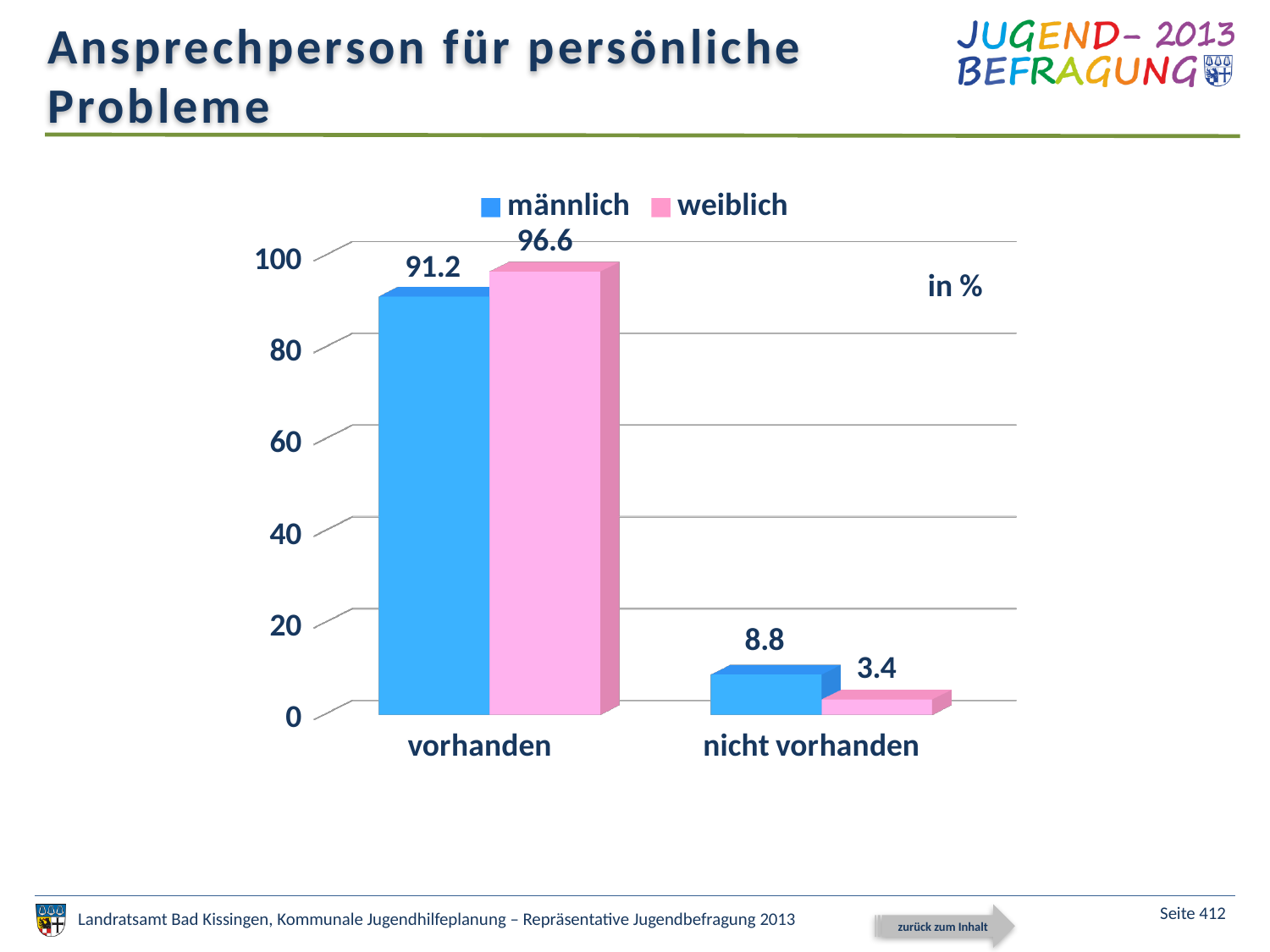
Which series has the higher value in the nicht vorhanden category? männlich What is the difference between the männlich and weiblich values in the nicht vorhanden category? 5.4 How many categories are shown on the x axis? 2 What is the value for weiblich in the nicht vorhanden category? 3.4 What is the value for männlich in the vorhanden category? 91.2 What is the value for männlich in the nicht vorhanden category? 8.8 What unit is indicated for the values in the chart? in % What kind of chart is shown on the slide? bar chart What is the difference between the weiblich and männlich values in the vorhanden category? 5.4 What is the value for weiblich in the vorhanden category? 96.6 How many series does the legend list? 2 Which series has the higher value in the vorhanden category? weiblich